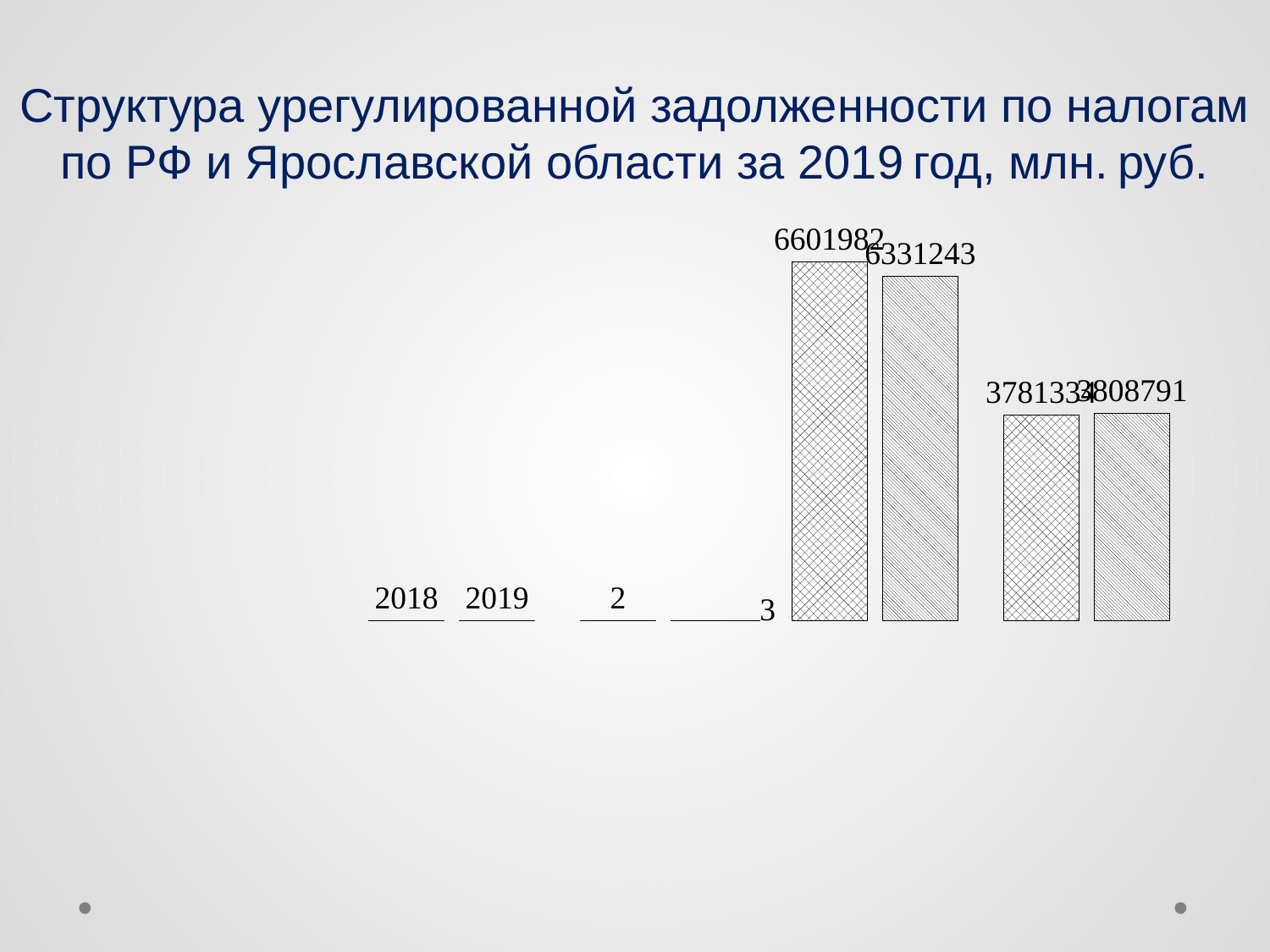
What is the value labelled on the fourth (rightmost) bar? 3808791 What kind of chart is shown on the slide? bar chart Which is larger, the first bar or the second bar? the first bar Which bar has the highest value? the first (leftmost) bar, 6601982 What is the title of the slide? Структура урегулированной задолженности по налогам по РФ и Ярославской области за 2019 год, млн. руб. Which is larger, the second bar or the fourth bar? the second bar What is the difference between the first bar (6601982) and the second bar (6331243)? 270739 What is the value labelled on the second bar from the left? 6331243 What is the value labelled on the first (leftmost) bar? 6601982 How many bars are plotted in the chart? 4 What unit is stated in the slide title for the values? млн. руб.